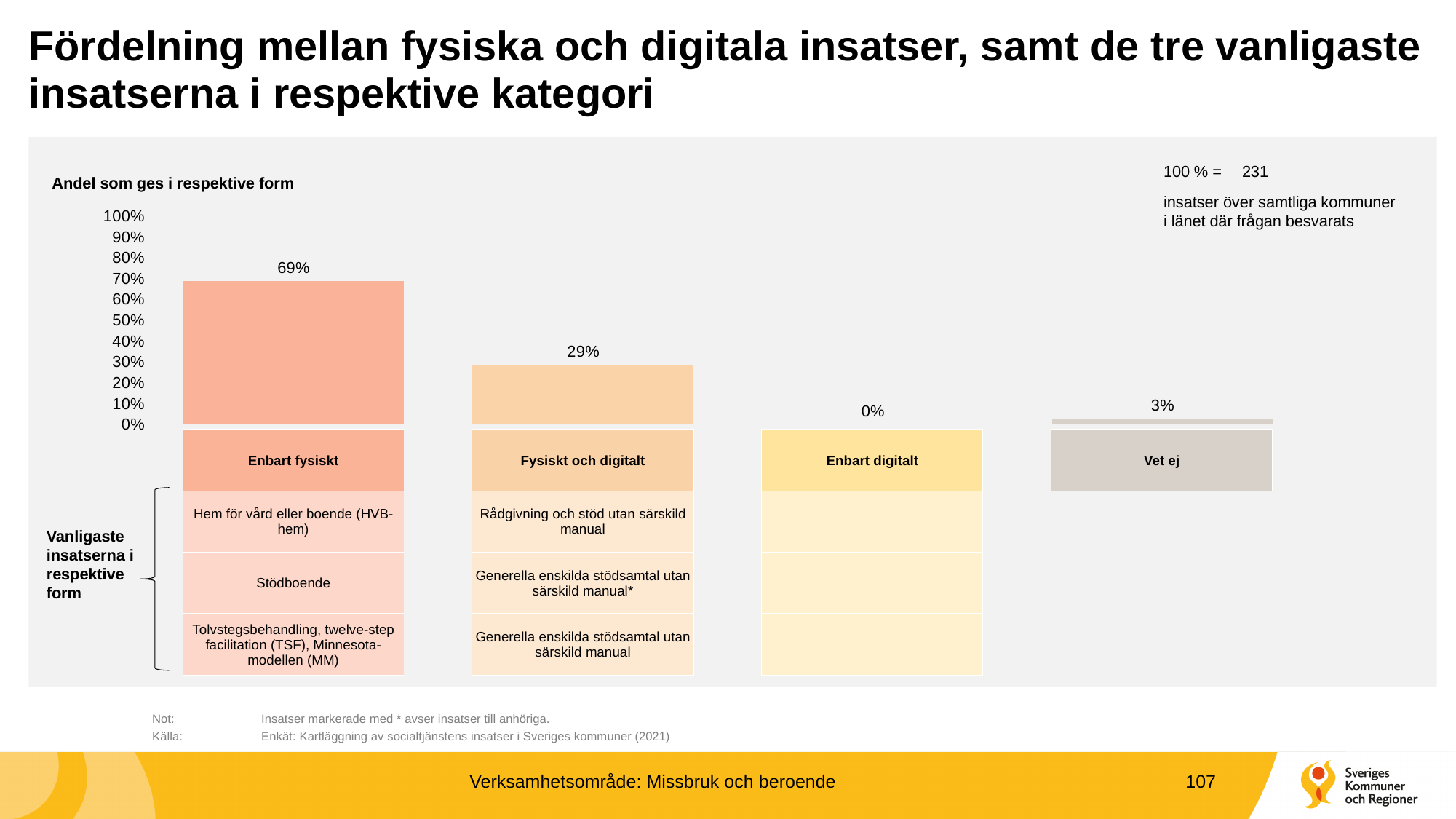
What is the difference between the values for Enbart fysiskt and Fysiskt och digitalt? 40 percentage points What is the value for Vet ej? 3% Which is larger, the value for Vet ej or the value for Enbart digitalt? Vet ej Which category has the lowest value? Enbart digitalt What is the value for Enbart fysiskt? 69% Is the value for Enbart fysiskt greater or less than 50%? greater What is the title of the chart? Andel som ges i respektive form What is the value for Enbart digitalt? 0% What is the value for Fysiskt och digitalt? 29% What kind of chart is shown on the slide? bar chart Which category has the highest value? Enbart fysiskt How many categories are shown in the chart? 4